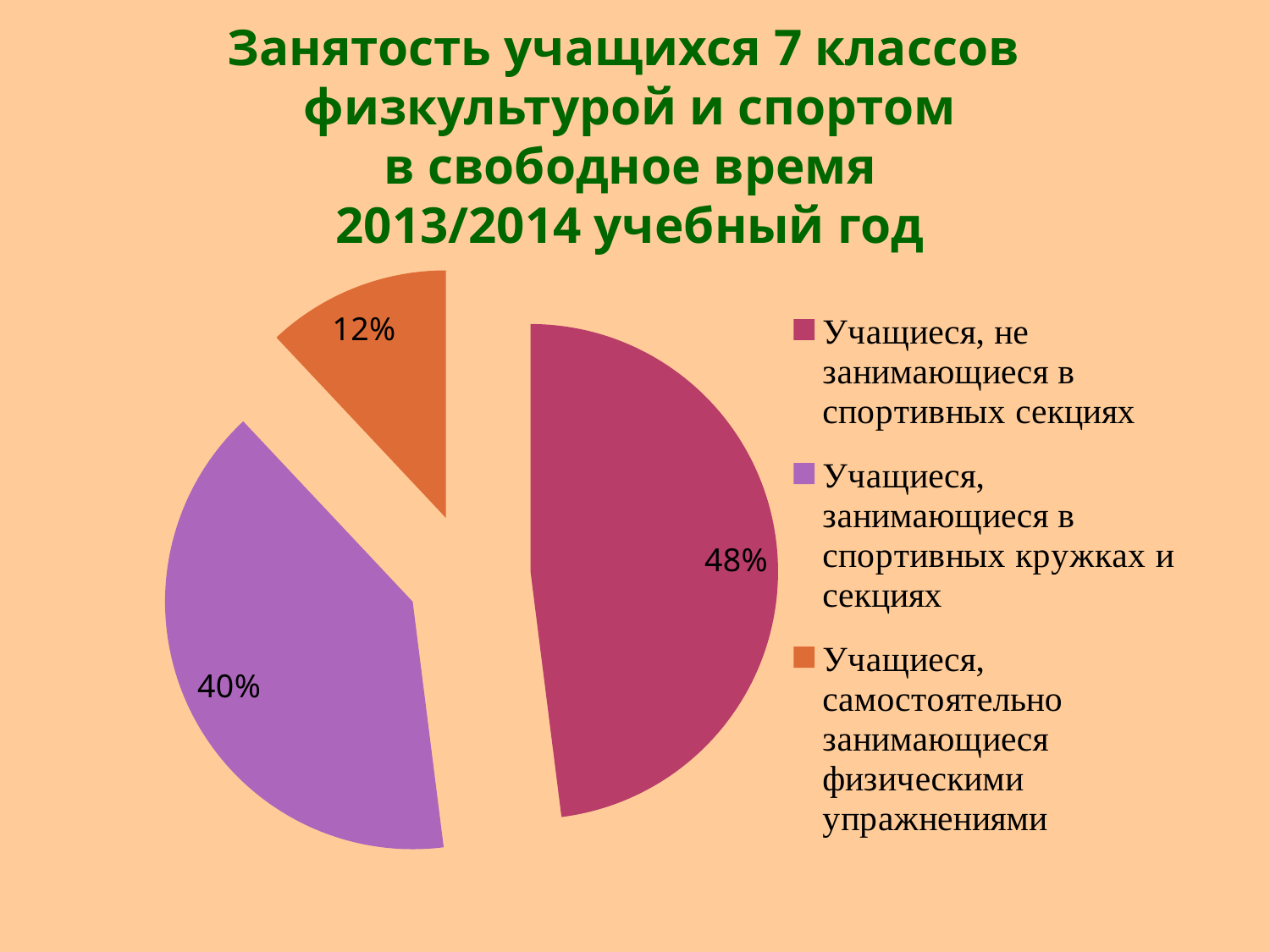
What colour is the slice for 'Учащиеся, самостоятельно занимающиеся физическими упражнениями'? orange Which category has the largest slice of the pie? Учащиеся, не занимающиеся в спортивных секциях Which category has the smallest slice of the pie? Учащиеся, самостоятельно занимающиеся физическими упражнениями What share of the pie is labelled for 'Учащиеся, не занимающиеся в спортивных секциях'? 48% What is the difference in percentage points between the slice for 'Учащиеся, не занимающиеся в спортивных секциях' and the slice for 'Учащиеся, самостоятельно занимающиеся физическими упражнениями'? 36% What kind of chart is shown on the slide? pie chart What is the difference in percentage points between the 48% slice and the 40% slice? 8% How many slices does the pie chart have? 3 Which is larger: the slice for 'Учащиеся, занимающиеся в спортивных кружках и секциях' or the slice for 'Учащиеся, самостоятельно занимающиеся физическими упражнениями'? Учащиеся, занимающиеся в спортивных кружках и секциях How many entries does the legend list? 3 What share of the pie is labelled for 'Учащиеся, занимающиеся в спортивных кружках и секциях'? 40% What share of the pie is labelled for 'Учащиеся, самостоятельно занимающиеся физическими упражнениями'? 12%